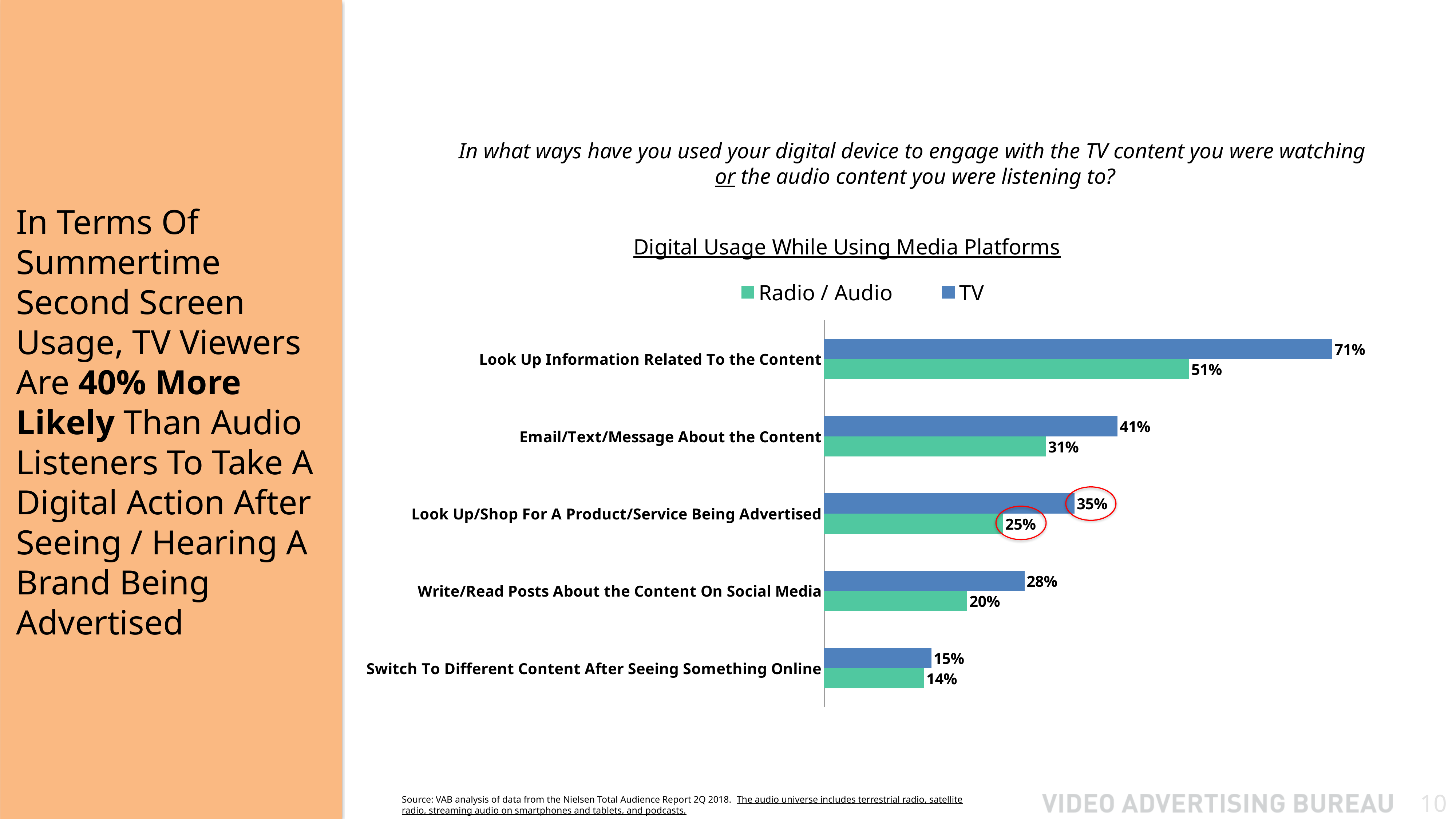
How many categories are shown in the chart? 5 What is the TV value for "Switch To Different Content After Seeing Something Online"? 15% What is the Radio / Audio value for "Email/Text/Message About the Content"? 31% Which category has the highest TV value? Look Up Information Related To the Content What is the Radio / Audio value for "Look Up/Shop For A Product/Service Being Advertised"? 25% For "Email/Text/Message About the Content", which series has the larger value, TV or Radio / Audio? TV How many series does the legend list? 2 What is the difference between the TV and Radio / Audio values for "Write/Read Posts About the Content On Social Media"? 8% What is the TV value for "Look Up Information Related To the Content"? 71% Which category has the lowest Radio / Audio value? Switch To Different Content After Seeing Something Online What kind of chart is shown on the slide? Bar chart What is the difference between the TV and Radio / Audio values for "Look Up Information Related To the Content"? 20%